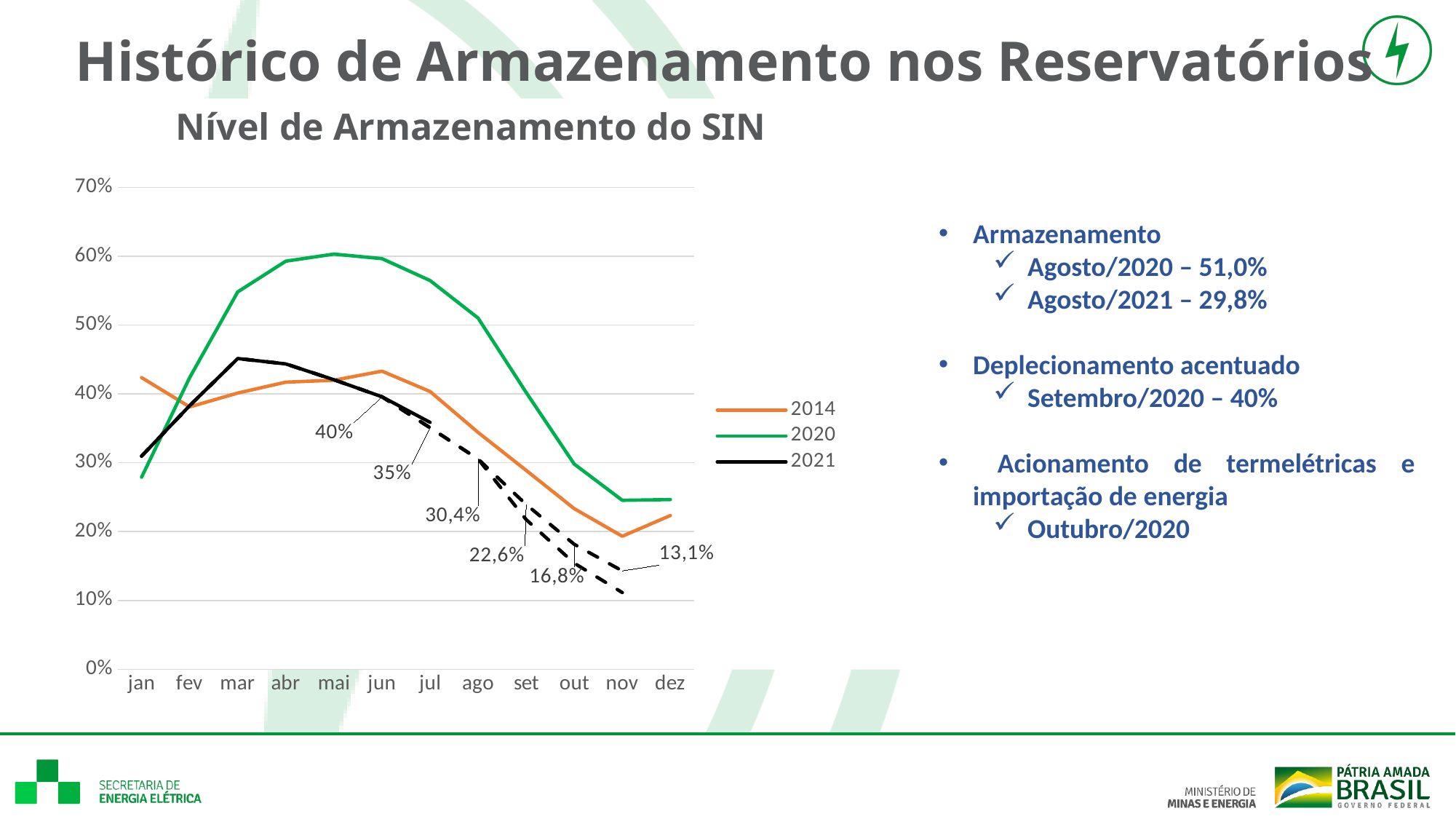
Does the 2020 series rise or fall from mai to nov? fall In jan, which series has the higher value, 2014 or 2020? 2014 How many months are shown on the x axis? 12 What kind of chart is shown on the slide? line chart Is the value for 2020 in mai greater or less than 50%? greater In which month does the 2021 series reach its highest value? mar In which month does the 2020 series reach its highest value? mai What value is labelled on the 2021 series for ago? 30,4% In which month does the 2014 series reach its lowest value? nov What value is labelled on the 2021 series for jun? 40% How many series does the legend list? 3 In mar, which series has the higher value, 2020 or 2021? 2020